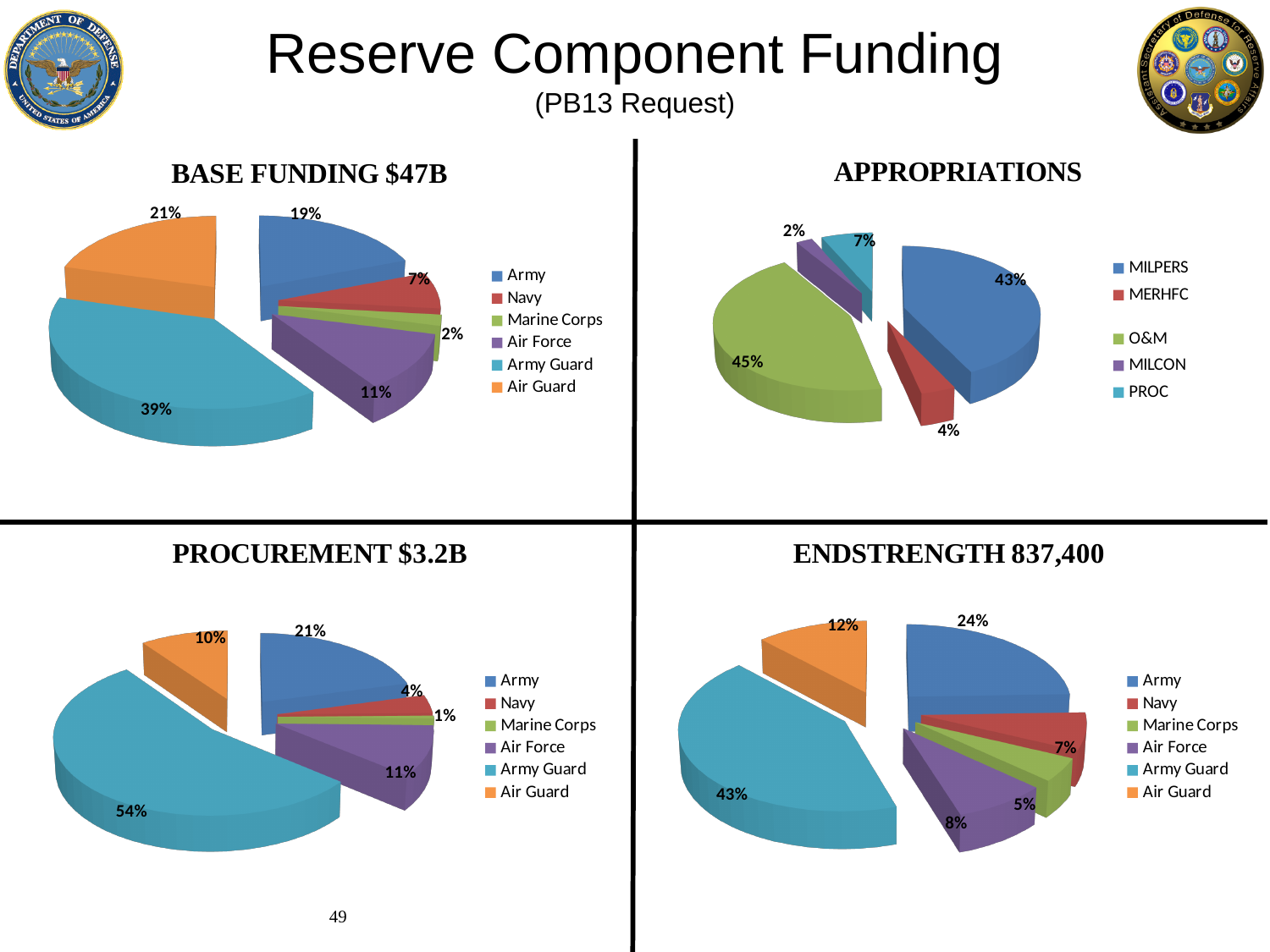
In the APPROPRIATIONS chart, which category has the largest share? O&M In the PROCUREMENT $3.2B chart, what share does Army Guard have? 54% In the BASE FUNDING $47B chart, what share does Army Guard have? 39% What kind of chart is the ENDSTRENGTH 837,400 chart? Pie chart In the ENDSTRENGTH 837,400 chart, what share does Air Force have? 8% In the PROCUREMENT $3.2B chart, which is larger, the Air Force share or the Air Guard share? Air Force In the ENDSTRENGTH 837,400 chart, what is the difference between the Army Guard and Army shares? 19% How many pie charts are shown on the slide? 4 How many categories does the legend of the APPROPRIATIONS chart list? 5 In the BASE FUNDING $47B chart, which category has the smallest share? Marine Corps In the BASE FUNDING $47B chart, what is the difference between the Air Guard and Army shares? 2% In the APPROPRIATIONS chart, what share does O&M have? 45%